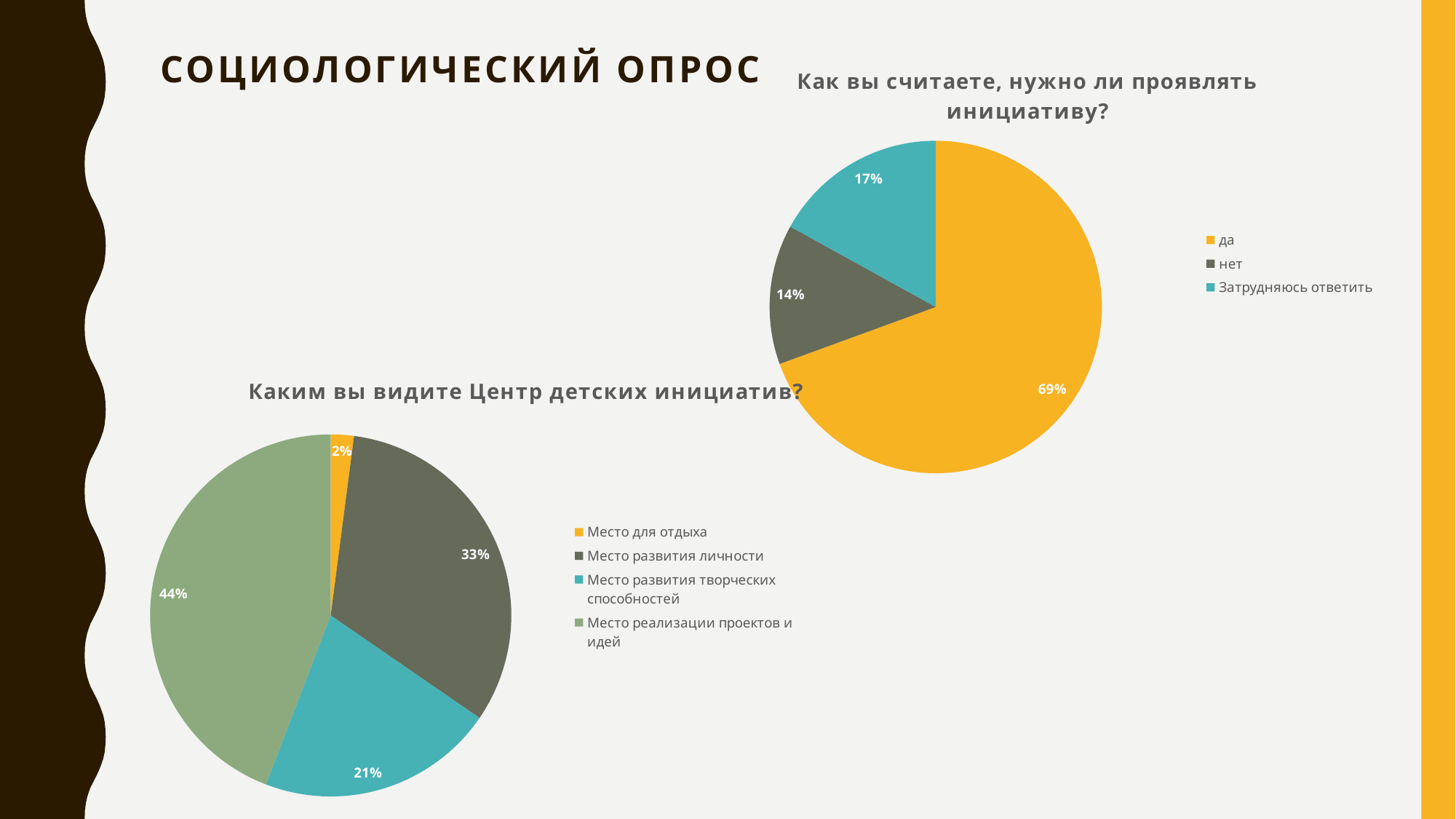
In the chart titled "Каким вы видите Центр детских инициатив?", what share is "Место реализации проектов и идей"? 44% In the chart titled "Каким вы видите Центр детских инициатив?", which is larger: "Место развития творческих способностей" or "Место развития личности"? Место развития личности In the chart titled "Каким вы видите Центр детских инициатив?", which category has the largest share? Место реализации проектов и идей In the chart titled "Как вы считаете, нужно ли проявлять инициативу?", what share of respondents chose "Затрудняюсь ответить"? 17% In the chart titled "Как вы считаете, нужно ли проявлять инициативу?", what share of respondents answered "нет"? 14% In the chart titled "Как вы считаете, нужно ли проявлять инициативу?", which answer has the smallest share? нет In the chart titled "Как вы считаете, нужно ли проявлять инициативу?", what share of respondents answered "да"? 69% In the chart titled "Каким вы видите Центр детских инициатив?", what share is "Место для отдыха"? 2% In the chart titled "Как вы считаете, нужно ли проявлять инициативу?", how many entries does the legend list? 3 In the chart titled "Каким вы видите Центр детских инициатив?", what share is "Место развития личности"? 33% In the chart titled "Как вы считаете, нужно ли проявлять инициативу?", what is the difference in percentage points between "да" and "нет"? 55 What type of chart is the chart titled "Каким вы видите Центр детских инициатив?"? Pie chart